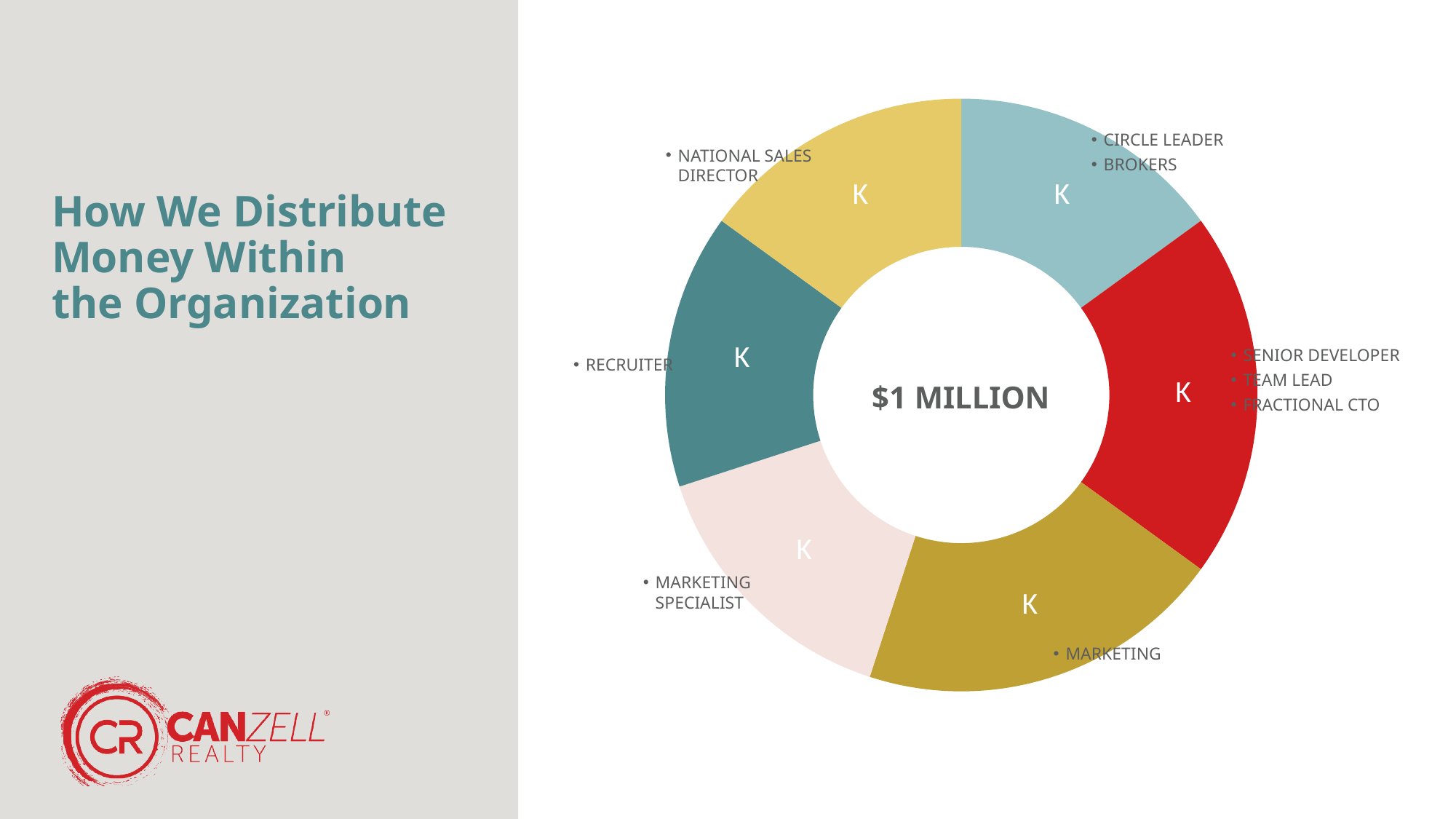
Which slice is larger: the Senior Developer / Team Lead / Fractional CTO slice or the Circle Leader / Brokers slice? Senior Developer / Team Lead / Fractional CTO How many slices does the donut chart have? 6 What text is shown in the center of the donut chart? $1 MILLION What kind of chart is shown on the slide? Donut (pie) chart Which slice is larger: the Senior Developer / Team Lead / Fractional CTO slice or the National Sales Director slice? Senior Developer / Team Lead / Fractional CTO What is the title of the slide containing the donut chart? How We Distribute Money Within the Organization